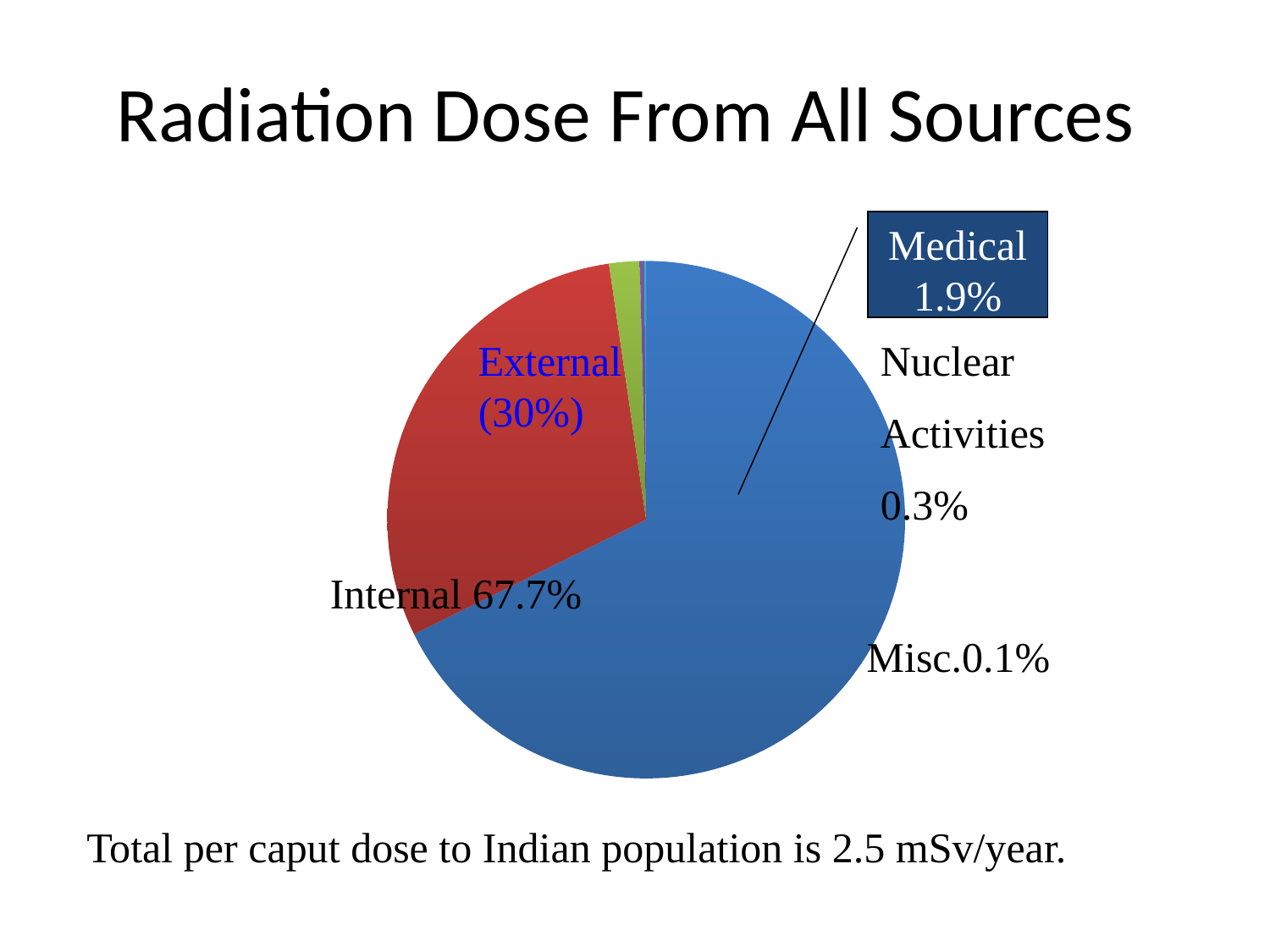
What percentage of the radiation dose is attributed to Nuclear Activities? 0.3% What kind of chart is shown on the slide? pie chart By how many percentage points does the Internal share exceed the External share? 37.7 What is the title of the chart on the slide? Radiation Dose From All Sources Which source accounts for the smallest share of the radiation dose? Misc. What share of the radiation dose comes from Internal sources? 67.7% Which is larger, the share for Medical or the share for Nuclear Activities? Medical What percentage of the radiation dose is attributed to Medical? 1.9% How many sources (slices) are shown in the pie chart? 5 What percentage of the radiation dose is attributed to Misc.? 0.1% What share of the radiation dose comes from External sources? 30% Which source accounts for the largest share of the radiation dose? Internal